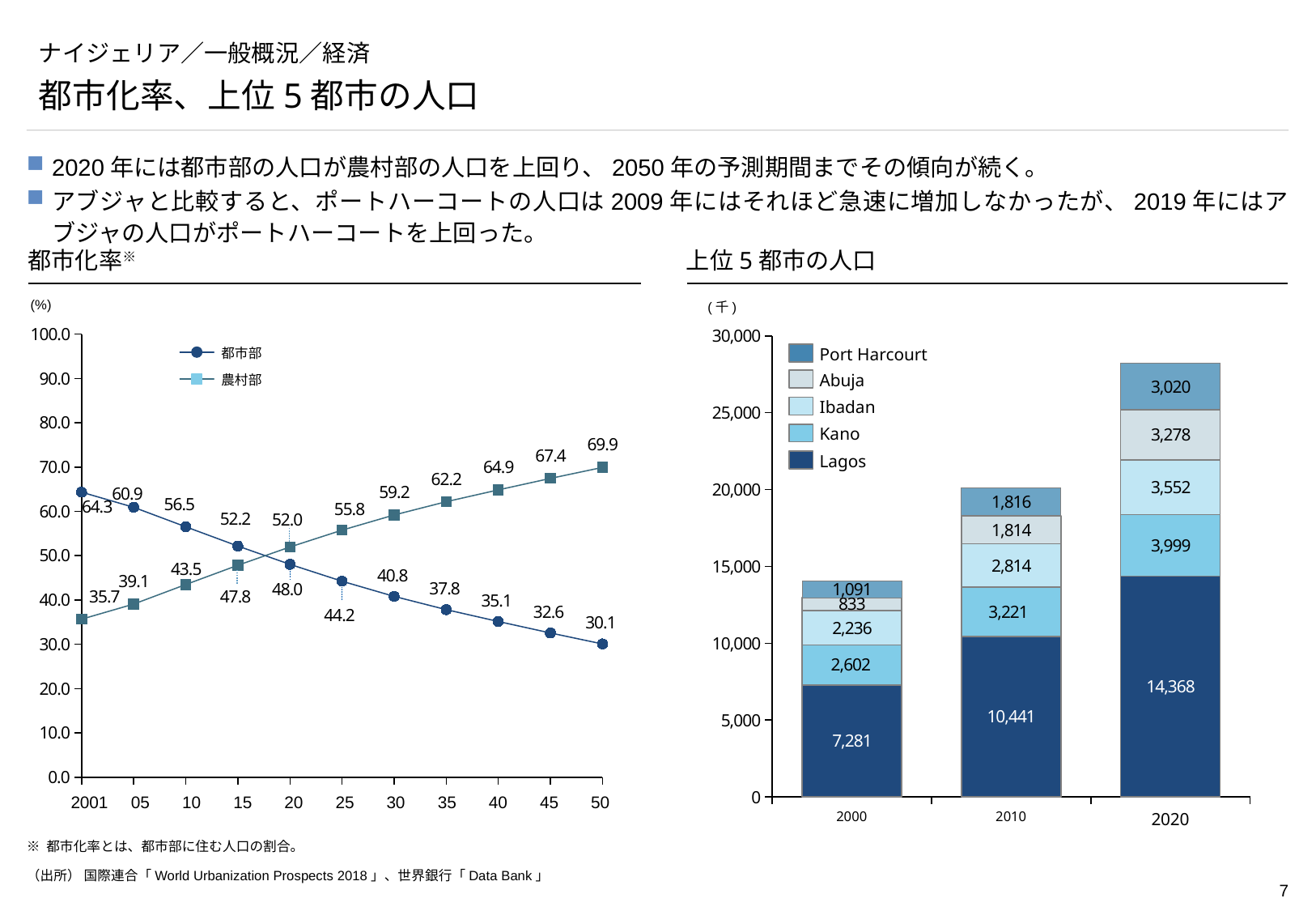
In the 上位5都市の人口 chart, what is the value for Lagos in 2020? 14,368 What kind of chart is the 都市化率 chart on the left? line chart How many series does the legend of the 上位5都市の人口 chart list? 5 In the 上位5都市の人口 chart, what is the difference between the Lagos values for 2020 and 2010? 3,927 In the 都市化率 chart, what is the value of the rising line (square markers) in 2050? 69.9 How many stacked bars are shown in the 上位5都市の人口 chart? 3 In the 都市化率 chart, what is the value of the line with circle markers in 2001? 64.3 In the 上位5都市の人口 chart, what is the value for Abuja in 2000? 833 In the 上位5都市の人口 chart, what is the total of the stacked bar for 2010? 20,106 In the 上位5都市の人口 chart, which is larger in 2020, Abuja or Port Harcourt? Abuja In the 都市化率 chart, does the line with circle markers rise or fall from 2001 to 2050? fall What kind of chart is the 上位5都市の人口 chart on the right? bar chart